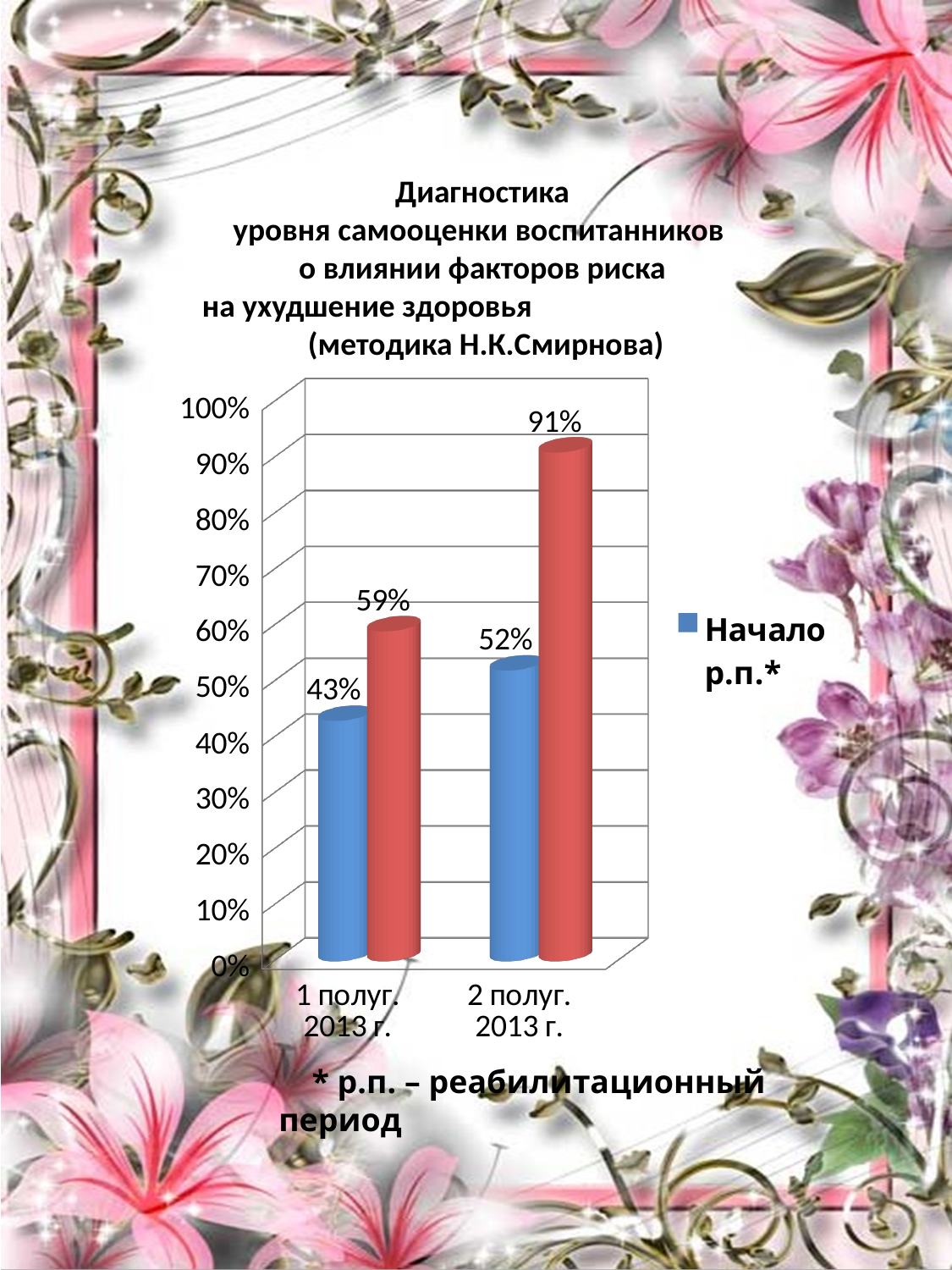
How many categories are shown on the x axis? 2 What is the value of the red bar for 2 полуг. 2013 г.? 91% What is the difference between the red bar values for 2 полуг. 2013 г. and 1 полуг. 2013 г.? 32% Which is larger for 2 полуг. 2013 г., the blue bar or the red bar? the red bar What is the difference between the red and blue bars for 1 полуг. 2013 г.? 16% Which bar has the lowest value on the chart? the blue bar for 1 полуг. 2013 г. (43%) What is the value of the red bar for 1 полуг. 2013 г.? 59% What type of chart is shown on the slide? bar chart Which bar has the highest value on the chart? the red bar for 2 полуг. 2013 г. (91%) What is the value of the blue bar (Начало р.п.*) for 2 полуг. 2013 г.? 52% Do the values of the blue series (Начало р.п.*) rise or fall from 1 полуг. 2013 г. to 2 полуг. 2013 г.? rise What is the value of the blue bar (Начало р.п.*) for 1 полуг. 2013 г.? 43%